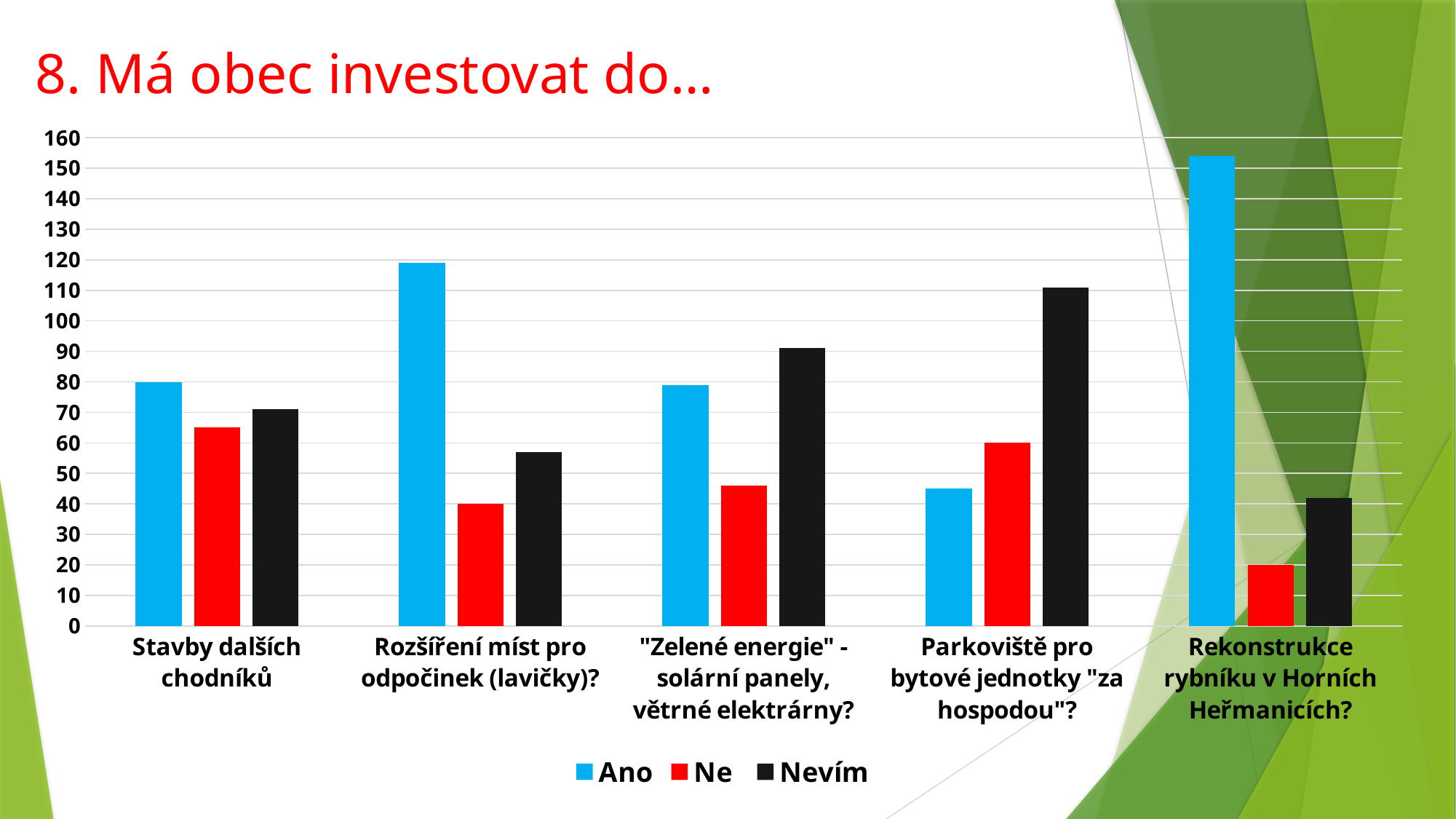
Is the Ano value for "Rozšíření míst pro odpočinek (lavičky)?" greater or less than 110? greater What are the three legend entries of the chart? Ano, Ne, Nevím What kind of chart is shown on the slide? bar chart Which category has the highest value for the Nevím series? Parkoviště pro bytové jednotky "za hospodou"? Is the Ano value for "Rekonstrukce rybníku v Horních Heřmanicích?" greater or less than 150? greater For "Parkoviště pro bytové jednotky "za hospodou"?", which is larger: the Ano value or the Ne value? Ne Which category has the highest value for the Ano series? Rekonstrukce rybníku v Horních Heřmanicích? How many categories are shown on the x axis? 5 Which category has the lowest value for the Ano series? Parkoviště pro bytové jednotky "za hospodou"? For "Zelené energie" - solární panely, větrné elektrárny?, which is larger: the Ano value or the Nevím value? Nevím Which category has the lowest value for the Ne series? Rekonstrukce rybníku v Horních Heřmanicích? How many series does the legend list? 3